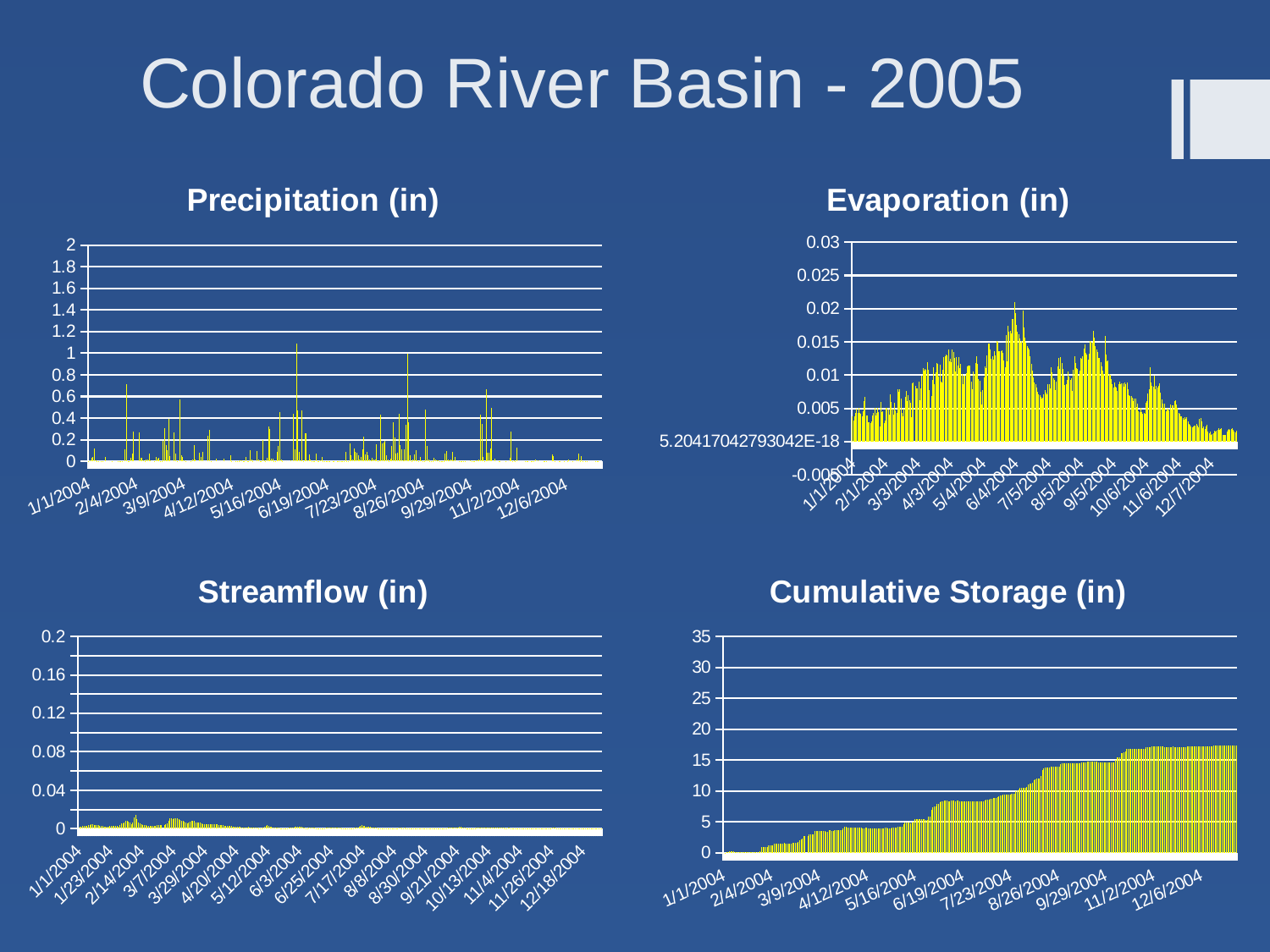
In the Evaporation (in) chart, is the highest value greater or less than 0.025? less In the Precipitation (in) chart, is the highest value greater or less than 0.8? greater What kind of chart is the Evaporation (in) chart? bar chart In the Cumulative Storage (in) chart, is the value at 12/6/2004 greater or less than 15? greater What is the title of the chart in the bottom-right of the slide? Cumulative Storage (in) In the Cumulative Storage (in) chart, do the values rise or fall along the x axis from 1/1/2004 to 12/6/2004? rise How many charts are shown on the slide? 4 What kind of chart is the Cumulative Storage (in) chart? bar chart What is the highest value shown on the y axis of the Precipitation (in) chart? 2